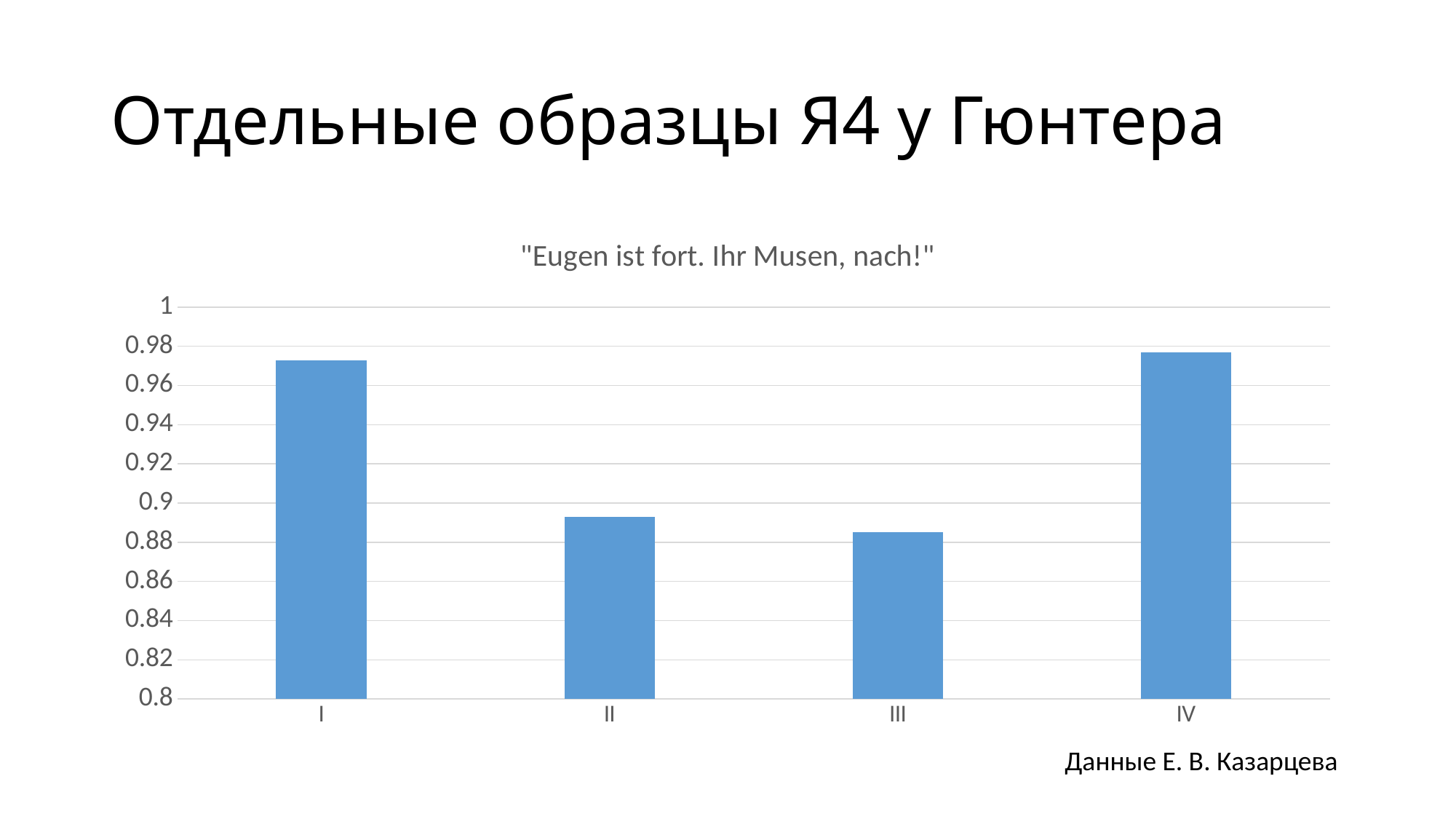
Is the value for category II greater or less than 0.9? less Is the value for category II greater or less than 0.88? greater Is the value for category I greater or less than 0.96? greater How many categories are plotted on the x axis of the chart? 4 What is the title of the chart? "Eugen ist fort. Ihr Musen, nach!" Which category has the lowest value in the chart? III What is the lowest value shown on the vertical axis of the chart? 0.8 Which is larger, the value for category I or the value for category II? I Which is larger, the value for category III or the value for category IV? IV What kind of chart is shown on the slide? bar chart